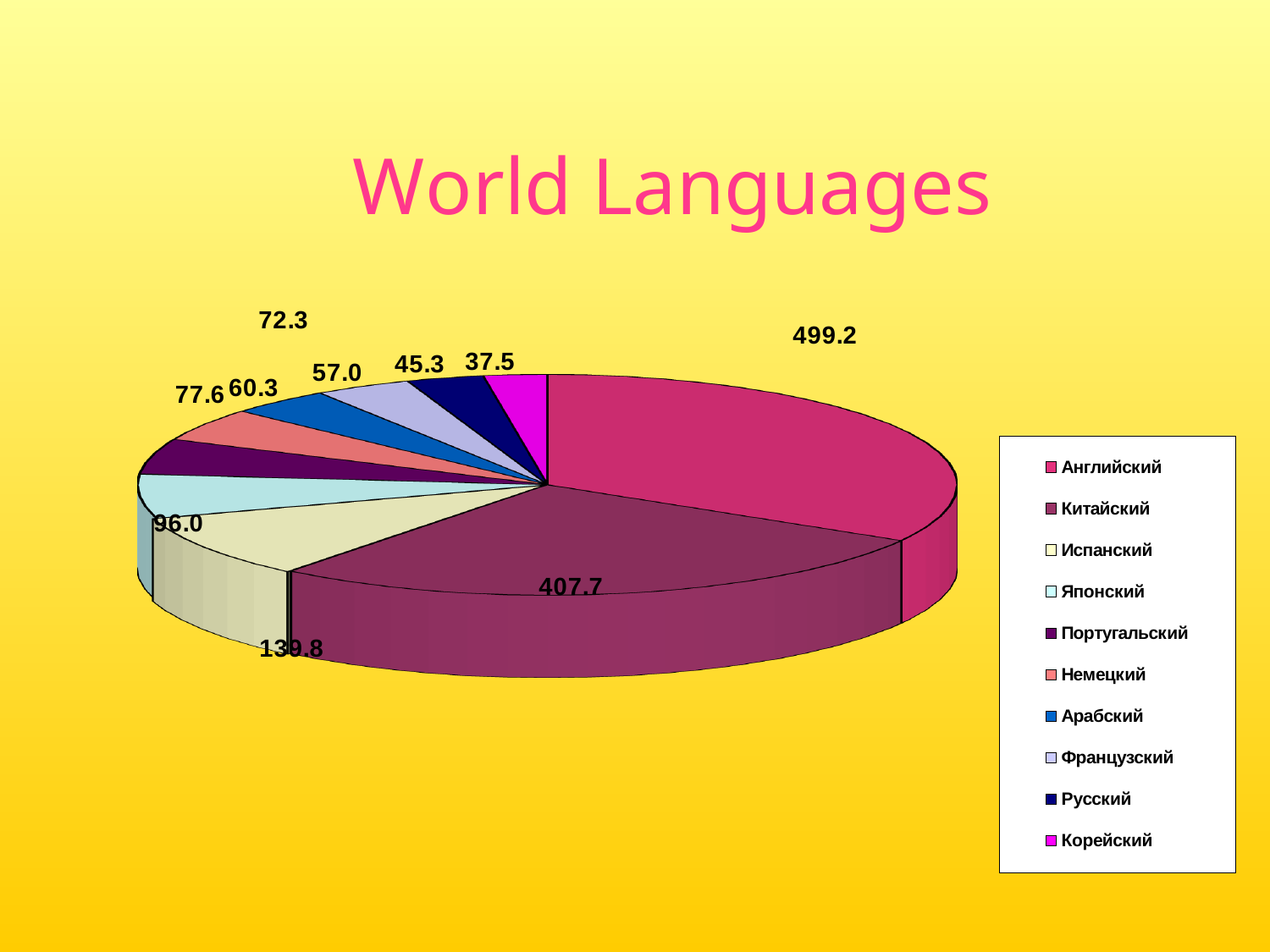
What kind of chart is shown on the slide? pie chart What is the value shown for Английский? 499.2 What is the value shown for Японский? 96.0 What is the value shown for Русский? 45.3 Which language has the smallest slice in the pie chart? Корейский How many languages (slices) does the pie chart show? 10 What is the value shown for Корейский? 37.5 What is the value shown for Китайский? 407.7 Which language has the largest slice in the pie chart? Английский What is the difference between the values for Английский and Китайский? 91.5 What is the title of the slide? World Languages Which is larger, the value for Японский or the value for Русский? Японский